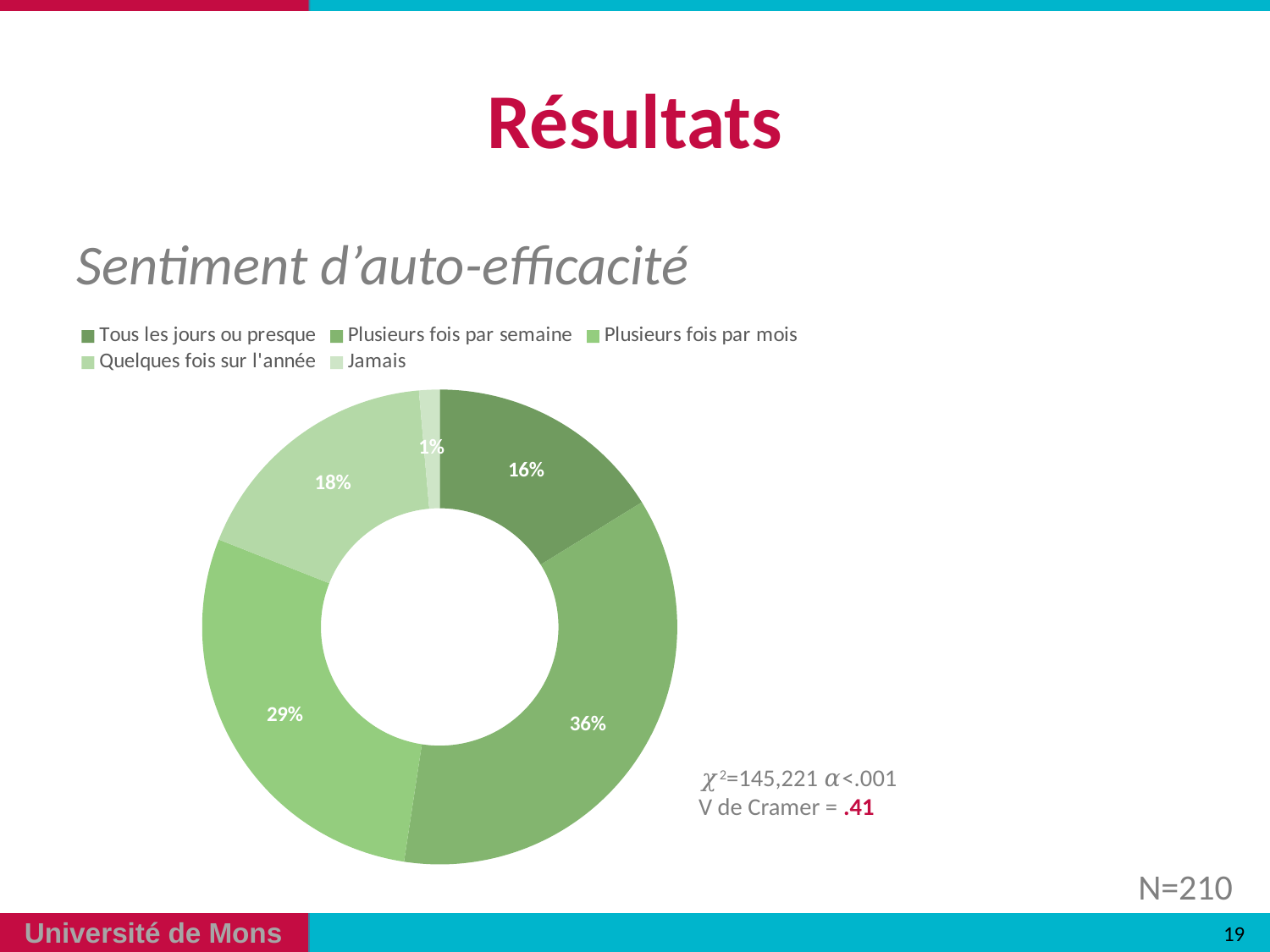
What is the value for "Jamais"? 1% How many categories does the chart show? 5 What is the title of the chart? Sentiment d'auto-efficacité Which is larger, the share for "Quelques fois sur l'année" or for "Tous les jours ou presque"? Quelques fois sur l'année Which category has the largest share? Plusieurs fois par semaine What is the value for "Tous les jours ou presque"? 16% What type of chart is shown on the slide? Doughnut chart What is the difference between the shares of "Plusieurs fois par semaine" and "Plusieurs fois par mois"? 7% What is the combined share of "Plusieurs fois par semaine" and "Plusieurs fois par mois"? 65% What is the value for "Quelques fois sur l'année"? 18% Which category has the smallest share? Jamais What is the value for "Plusieurs fois par semaine"? 36%